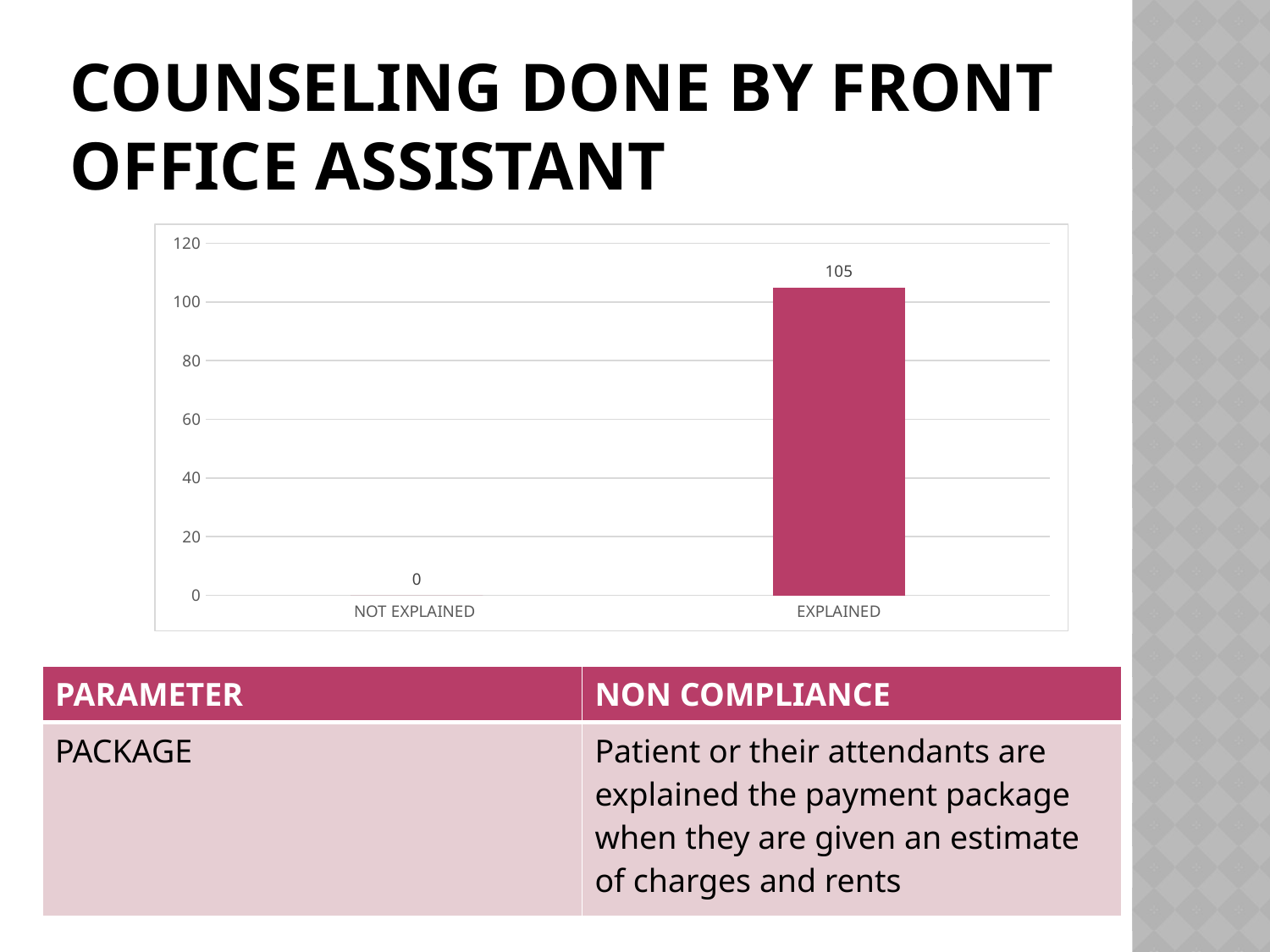
Which is larger, the value for EXPLAINED or the value for NOT EXPLAINED? EXPLAINED Which category has the highest value? EXPLAINED What is the highest value shown on the y axis? 120 Which category has the lowest value? NOT EXPLAINED What colour is the bar for EXPLAINED? pink/magenta Is the value for EXPLAINED greater or less than 100? greater What is the value for NOT EXPLAINED? 0 How many categories are shown on the x axis? 2 What is the difference between the values for EXPLAINED and NOT EXPLAINED? 105 What kind of chart is shown on the slide? bar chart Do the values rise or fall from NOT EXPLAINED to EXPLAINED? rise What is the value for EXPLAINED? 105